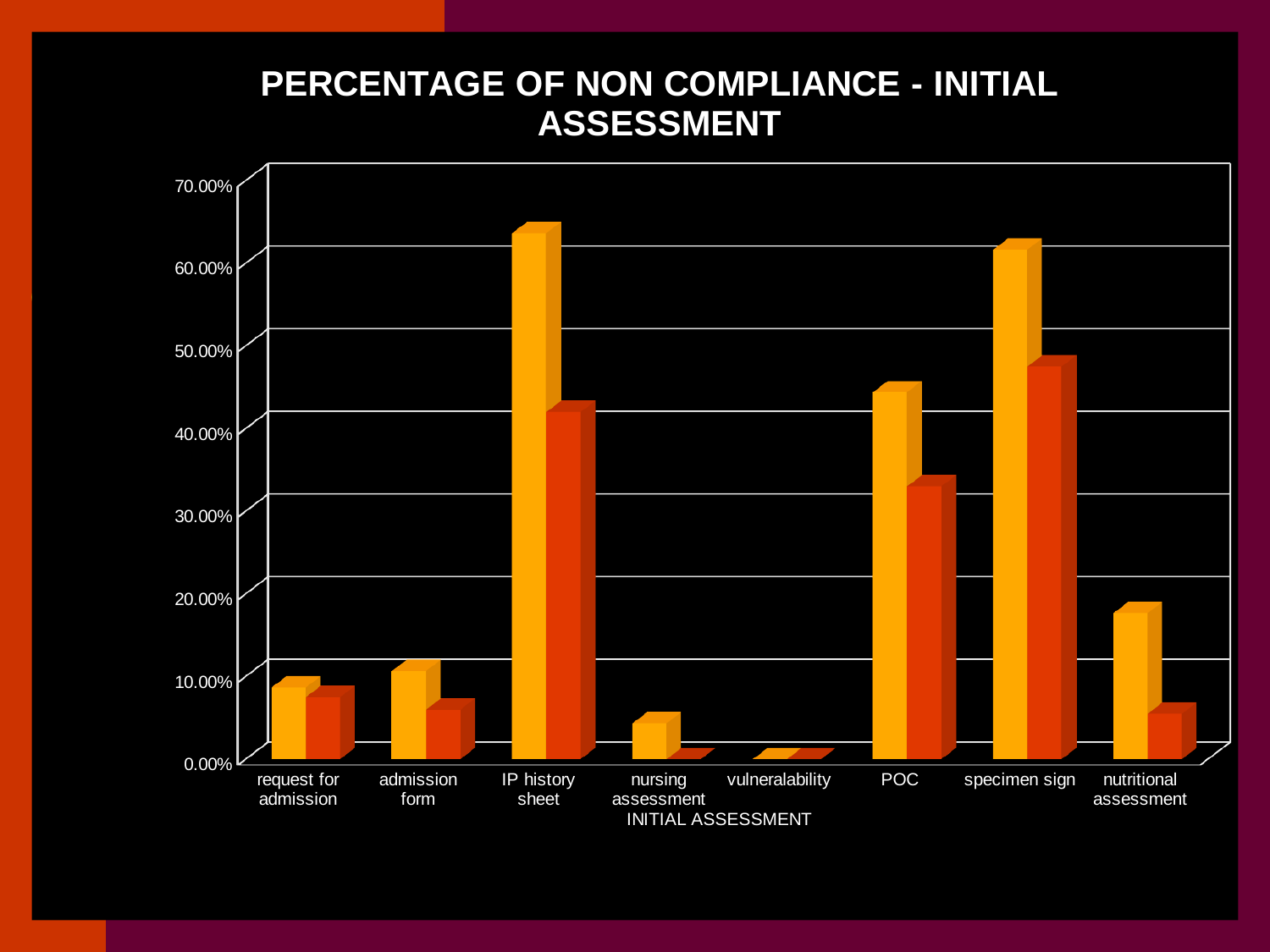
How many categories are shown on the x axis of the chart? 8 Is the yellow (first) bar for nutritional assessment greater or less than 20.00%? less What is the label of the x axis of the chart? INITIAL ASSESSMENT Is the yellow (first) bar for POC greater or less than 40.00%? greater Which category has the lowest values in the chart? vulneralability Which category has the highest value for the red (second) bars? specimen sign Is the red (second) bar for admission form greater or less than 10.00%? less What kind of chart is shown on the slide? bar chart What is the title of the chart? PERCENTAGE OF NON COMPLIANCE - INITIAL ASSESSMENT For POC, which bar is larger, the yellow (first) bar or the red (second) bar? the yellow (first) bar